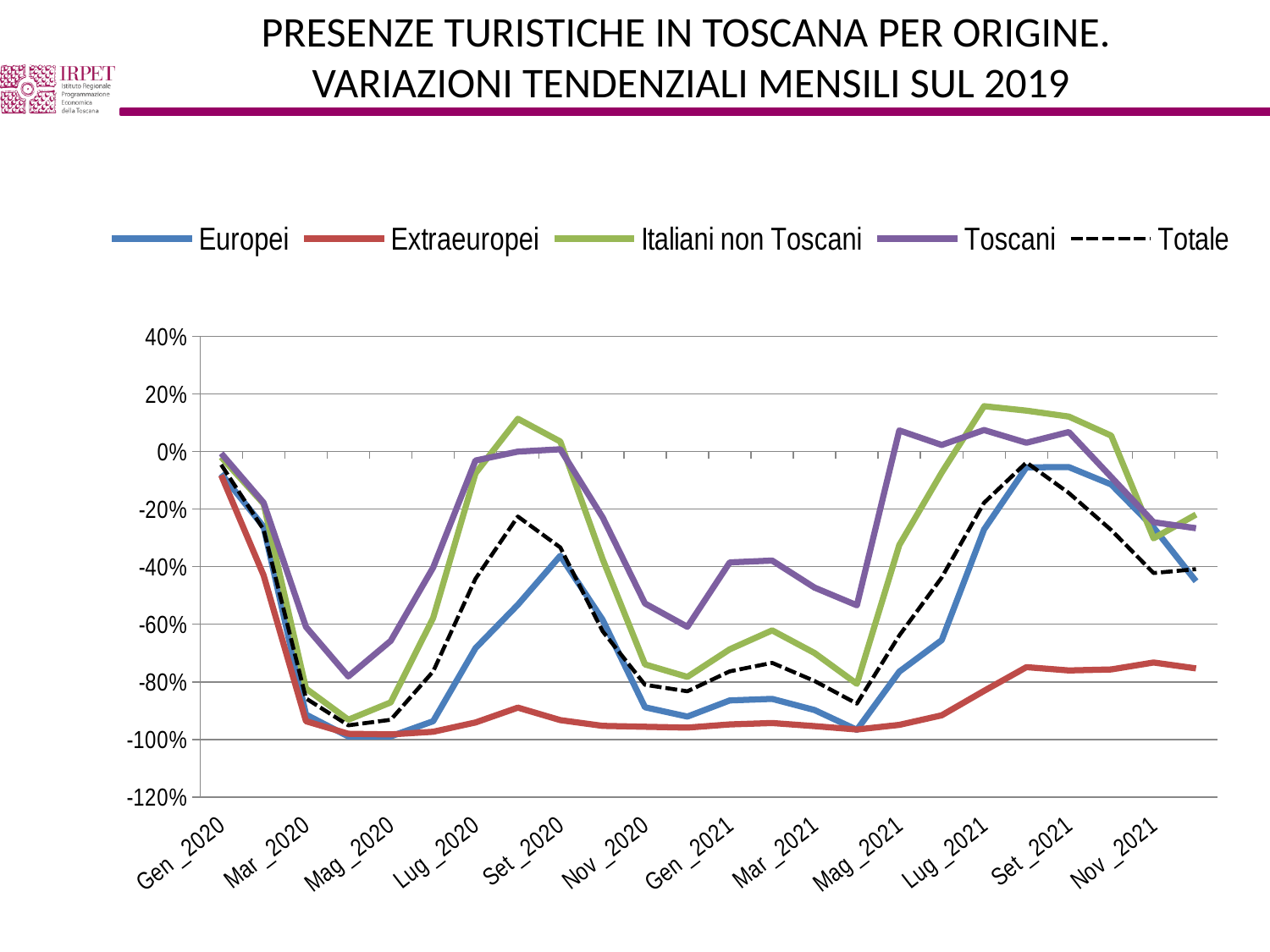
At Lug_2021, which is higher: Italiani non Toscani or Europei? Italiani non Toscani Which series is drawn as a dashed line? Totale Does the Extraeuropei line rise or fall between Mag_2021 and Set_2021? rise At Mag_2020, which is higher: Toscani or Extraeuropei? Toscani Which series has the lowest value at Nov_2021? Extraeuropei What kind of chart is shown on the slide? line chart Is the value for Extraeuropei at Mag_2020 greater or less than -80%? less Is the value for Europei at Nov_2020 greater or less than -80%? less Is the value for Italiani non Toscani at Lug_2021 greater or less than 0%? greater How many month labels are shown on the x axis? 12 How many series does the legend list? 5